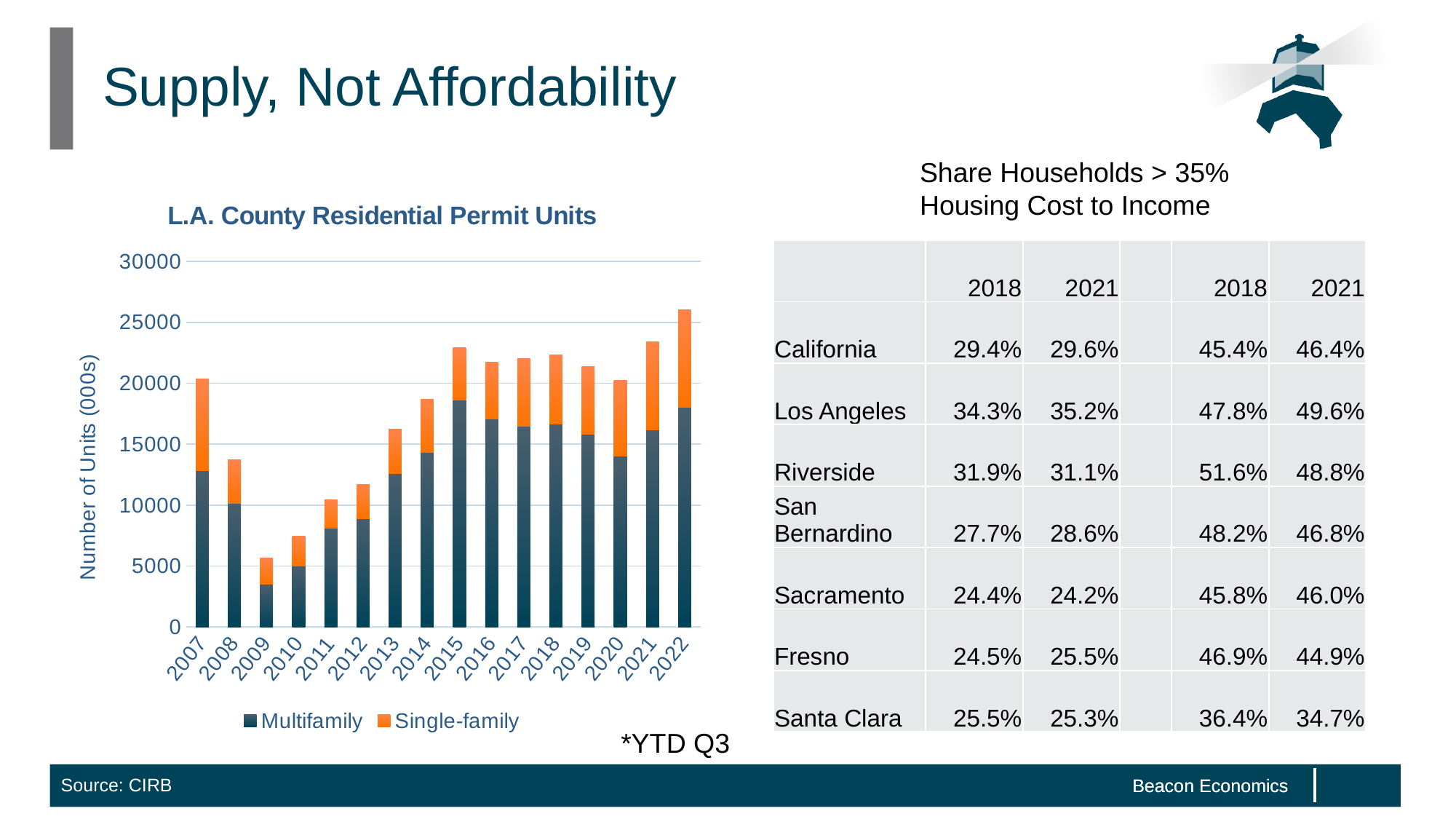
Do total permit units rise or fall from 2009 to 2015? rise How many series does the legend of the L.A. County Residential Permit Units chart list? 2 Which year has the highest total permit units in the L.A. County Residential Permit Units chart? 2022 Which year has a larger total of permit units, 2008 or 2013? 2013 Is the total value for 2010 greater or less than 10000? less Is the total value for 2022 greater or less than 25000? greater How many years are shown on the x axis of the L.A. County Residential Permit Units chart? 16 What is the label on the y axis of the L.A. County Residential Permit Units chart? Number of Units (000s) Which year has the lowest Multifamily permit units in the chart? 2009 Which year has the lowest total permit units in the L.A. County Residential Permit Units chart? 2009 What kind of chart is shown on the slide? Stacked bar chart